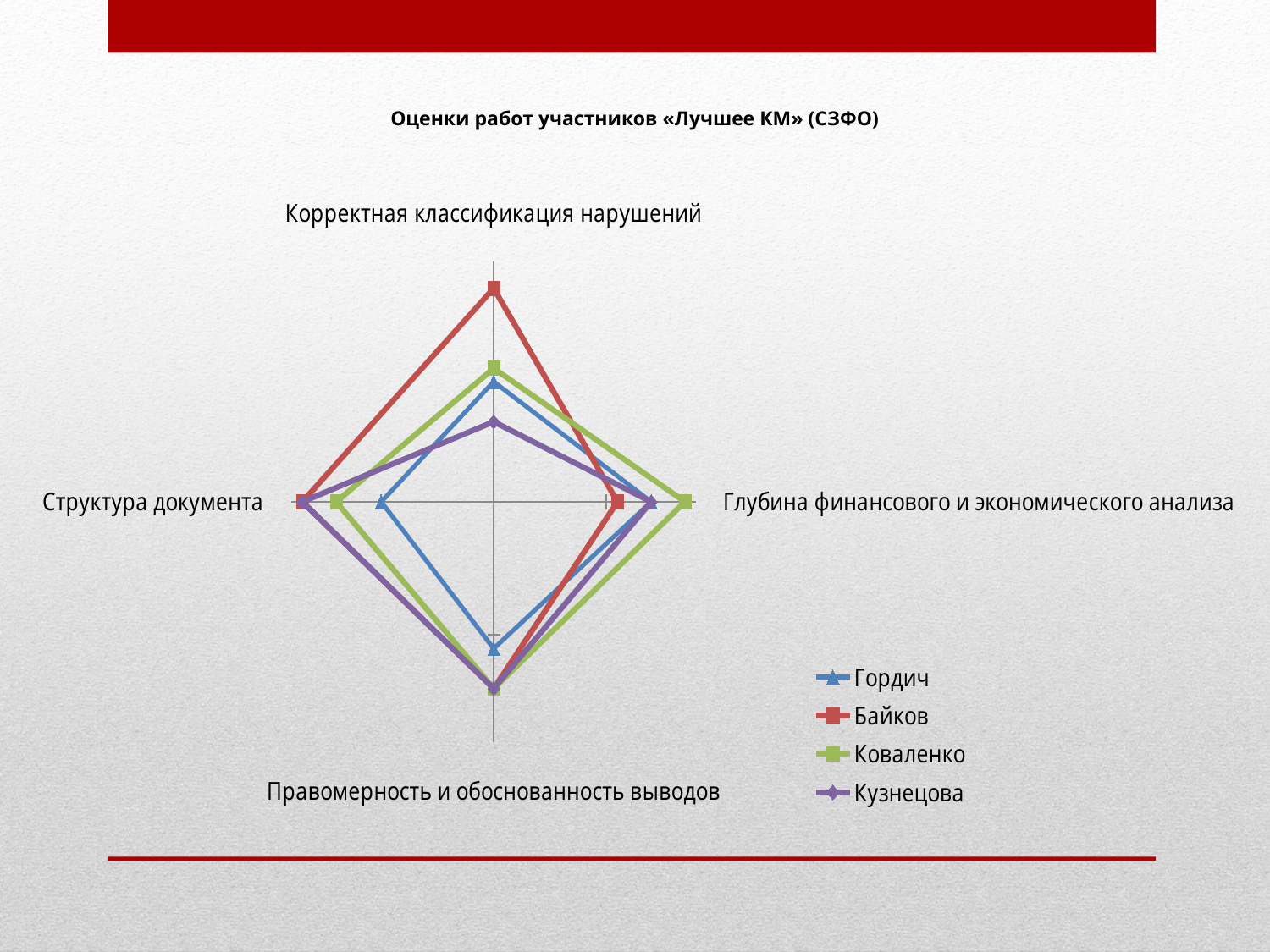
How many series does the legend list? 4 For «Структура документа», who scores higher: Коваленко or Гордич? Коваленко What is the title of the chart? Оценки работ участников «Лучшее КМ» (СЗФО) How many criteria (axes) does the radar chart have? 4 Which participant has the lowest score for «Структура документа»? Гордич Which participant has the lowest score for «Корректная классификация нарушений»? Кузнецова Which participant has the lowest score for «Правомерность и обоснованность выводов»? Гордич Which participant has the highest score for «Корректная классификация нарушений»? Байков What kind of chart is shown on the slide? Radar chart Which participant has the highest score for «Глубина финансового и экономического анализа»? Коваленко For «Корректная классификация нарушений», who scores higher: Байков or Кузнецова? Байков